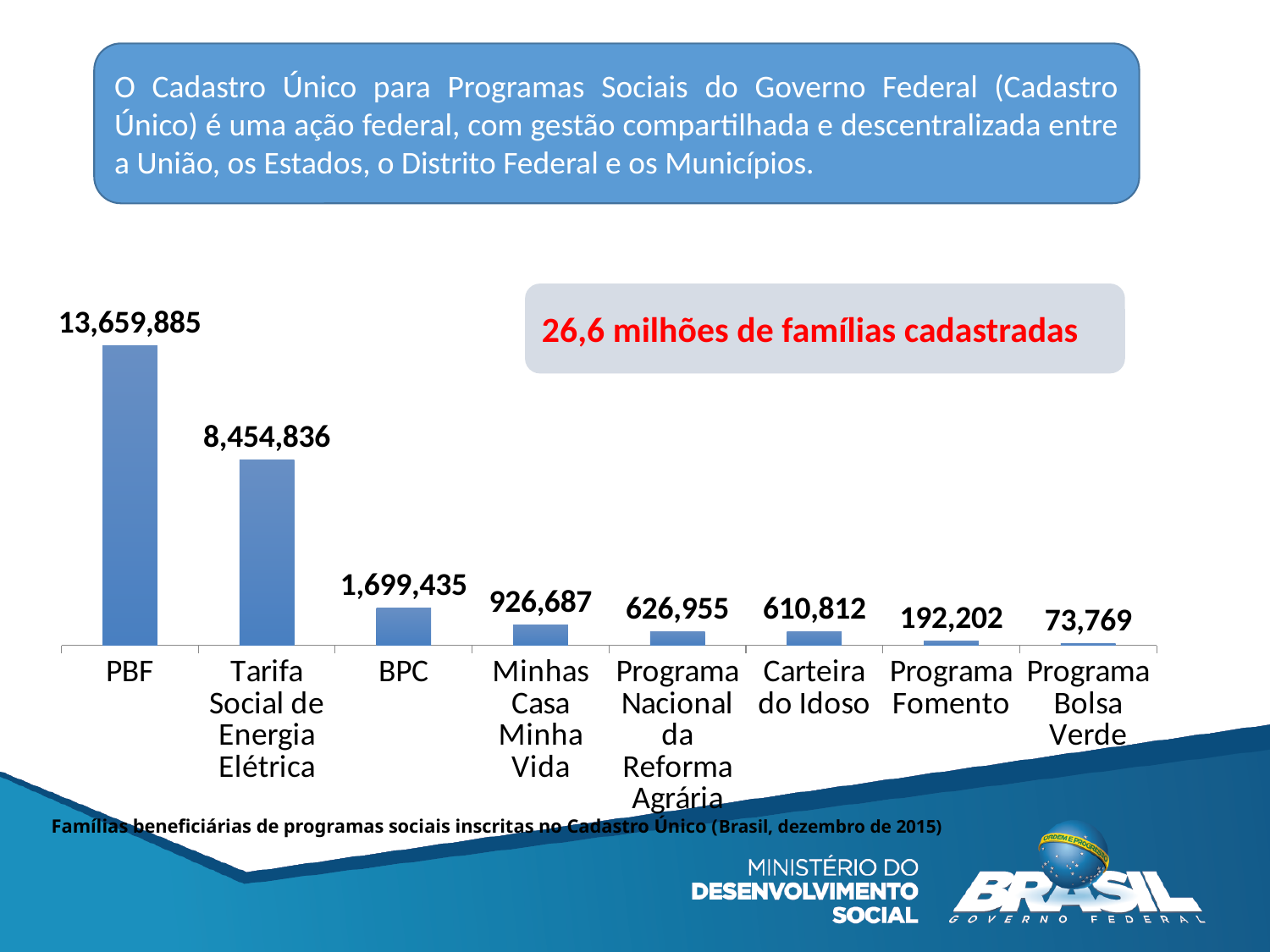
Do the values rise or fall from left to right along the x axis? Fall How many categories are shown in the chart? 8 What is the difference between the values for Programa Fomento and Programa Bolsa Verde? 118,433 What is the difference between the values for PBF and Tarifa Social de Energia Elétrica? 5,205,049 What kind of chart is shown on the slide? Bar chart What is the value for PBF? 13,659,885 Which category has the lowest value? Programa Bolsa Verde What is the value for BPC? 1,699,435 What is the value for Tarifa Social de Energia Elétrica? 8,454,836 Which is larger, the value for Programa Nacional da Reforma Agrária or the value for Carteira do Idoso? Programa Nacional da Reforma Agrária What is the value for Carteira do Idoso? 610,812 Which category has the highest value? PBF